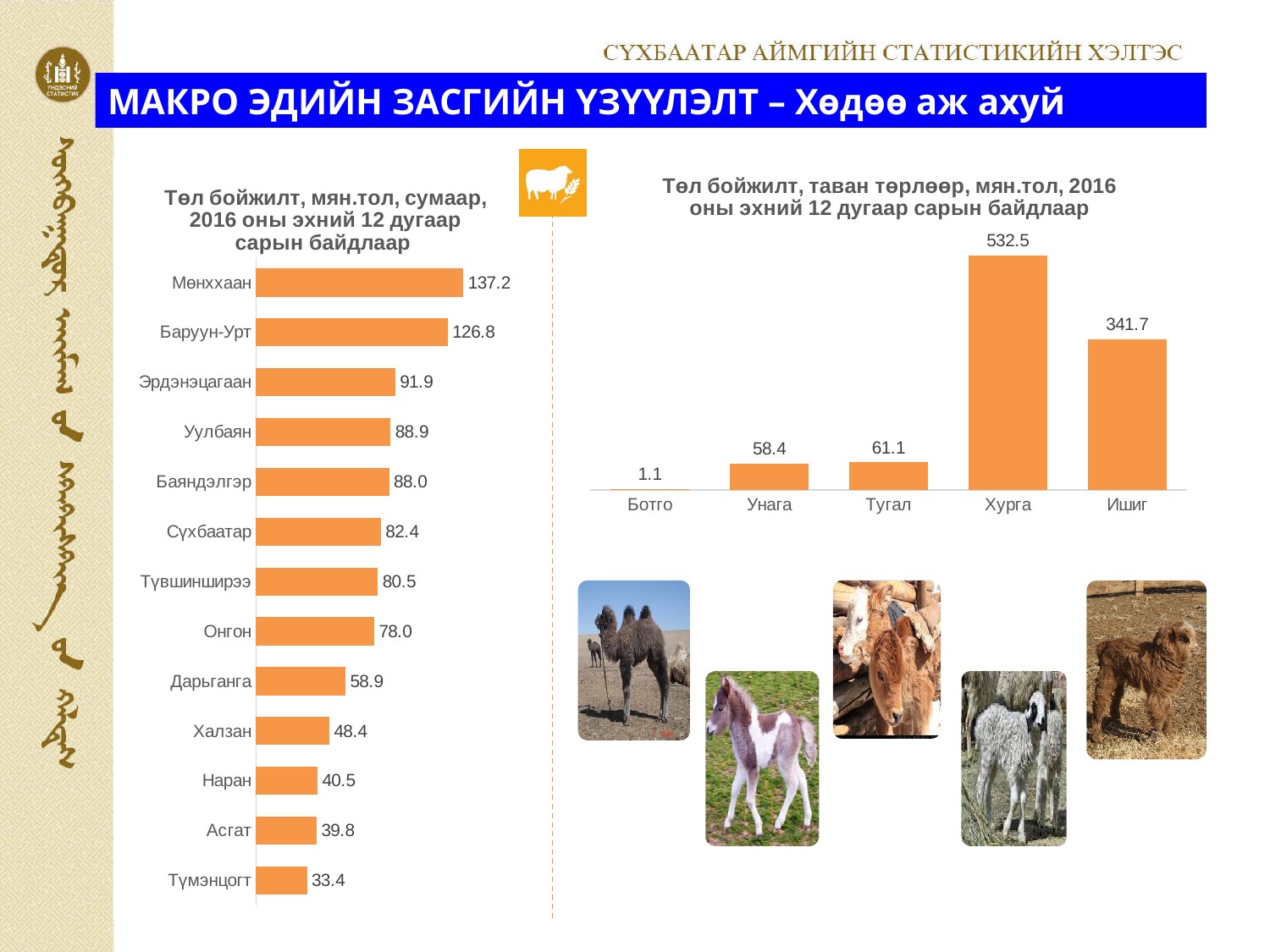
In the right chart (Төл бойжилт, таван төрлөөр), what is the value for Хурга? 532.5 In the right chart (Төл бойжилт, таван төрлөөр), what is the difference between Хурга and Ишиг? 190.8 In the left chart (Төл бойжилт, мян.тол, сумаар), which is larger, Наран or Асгат? Наран In the left chart (Төл бойжилт, мян.тол, сумаар), how many soums are shown? 13 In the right chart (Төл бойжилт, таван төрлөөр), which category has the highest value? Хурга In the left chart (Төл бойжилт, мян.тол, сумаар), what is the value for Мөнххаан? 137.2 In the left chart (Төл бойжилт, мян.тол, сумаар), what is the difference between Мөнххаан and Баруун-Урт? 10.4 In the left chart (Төл бойжилт, мян.тол, сумаар), which soum has the lowest value? Түмэнцогт What kind of chart is the left chart (Төл бойжилт, мян.тол, сумаар)? Bar chart In the right chart (Төл бойжилт, таван төрлөөр), which category has the lowest value? Ботго In the left chart (Төл бойжилт, мян.тол, сумаар), what is the value for Сүхбаатар? 82.4 In the right chart (Төл бойжилт, таван төрлөөр), how many categories are shown? 5